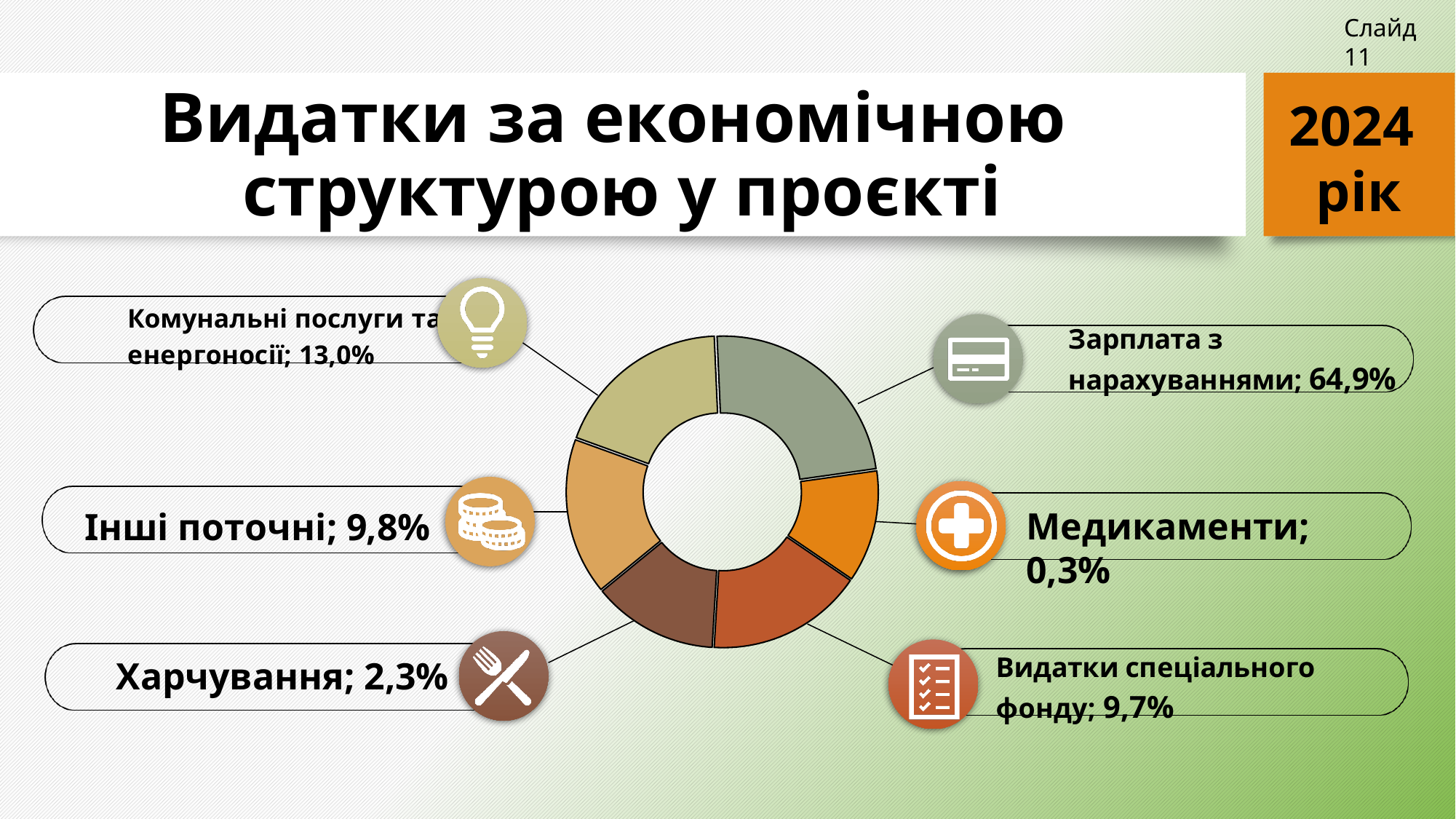
What share is shown for Медикаменти? 0,3% What share is shown for Інші поточні? 9,8% How many categories does the chart show? 6 Which is larger: the share of Інші поточні or the share of Видатки спеціального фонду? Інші поточні What share is shown for Комунальні послуги та енергоносії? 13,0% What kind of chart is shown on the slide? Doughnut chart Which category has the largest share? Зарплата з нарахуваннями Which category has the smallest share? Медикаменти What is the difference between the shares of Зарплата з нарахуваннями and Комунальні послуги та енергоносії? 51,9% What share is shown for Видатки спеціального фонду? 9,7% What share is shown for Зарплата з нарахуваннями? 64,9% What share is shown for Харчування? 2,3%